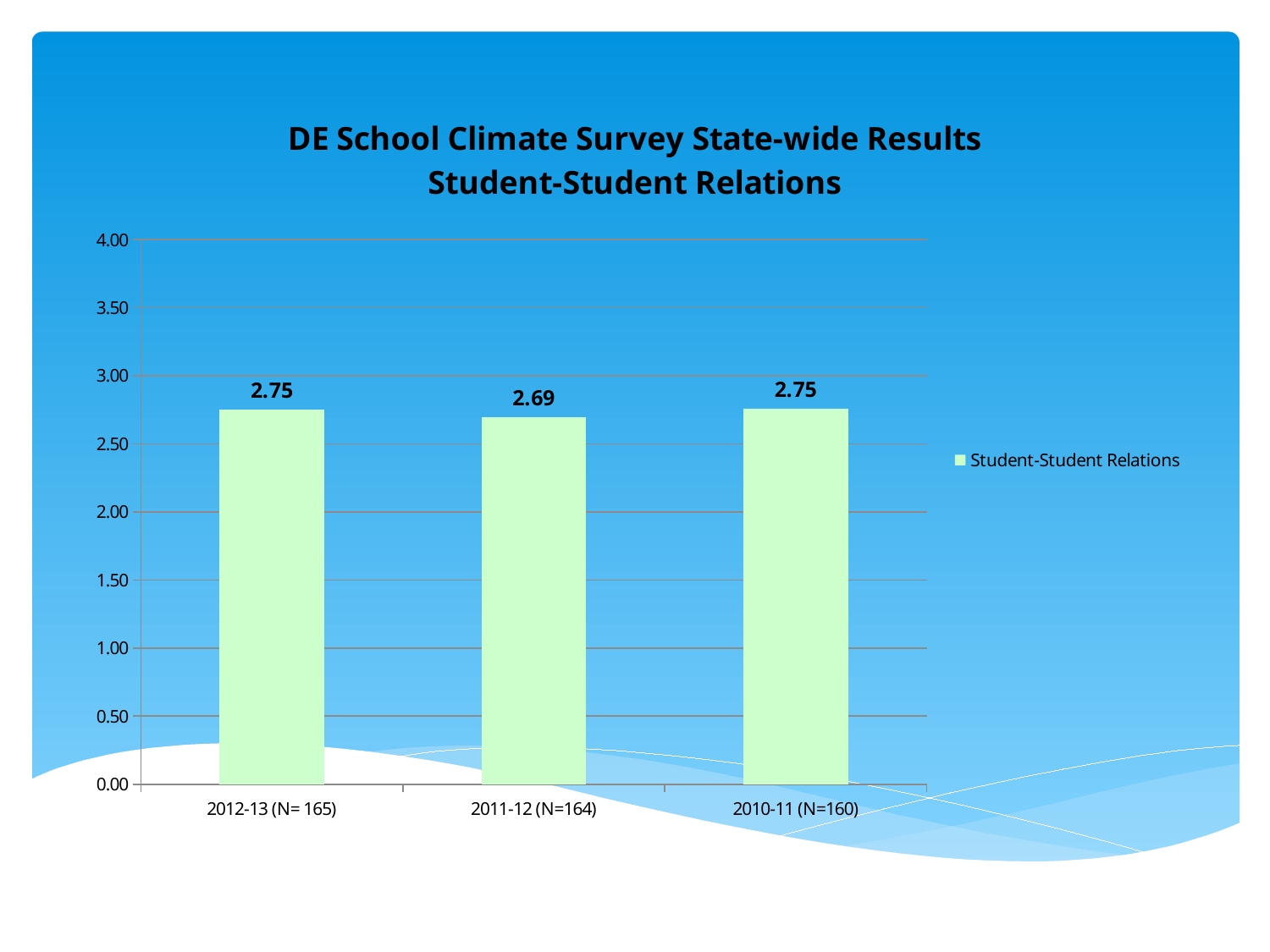
What is the Student-Student Relations value for 2011-12 (N=164)? 2.69 What is the Student-Student Relations value for 2010-11 (N=160)? 2.75 What is the title of the chart? DE School Climate Survey State-wide Results Student-Student Relations What is the maximum value shown on the y axis? 4.00 Is the value for 2011-12 (N=164) greater or less than 3.00? less What is the Student-Student Relations value for 2012-13 (N= 165)? 2.75 How many categories are shown on the x axis? 3 Which is larger, the value for 2011-12 (N=164) or the value for 2010-11 (N=160)? 2010-11 (N=160) How many series does the legend list? 1 What kind of chart is shown on the slide? bar chart What is the difference between the 2012-13 value and the 2011-12 value? 0.06 Which year has the lowest Student-Student Relations value? 2011-12 (N=164)